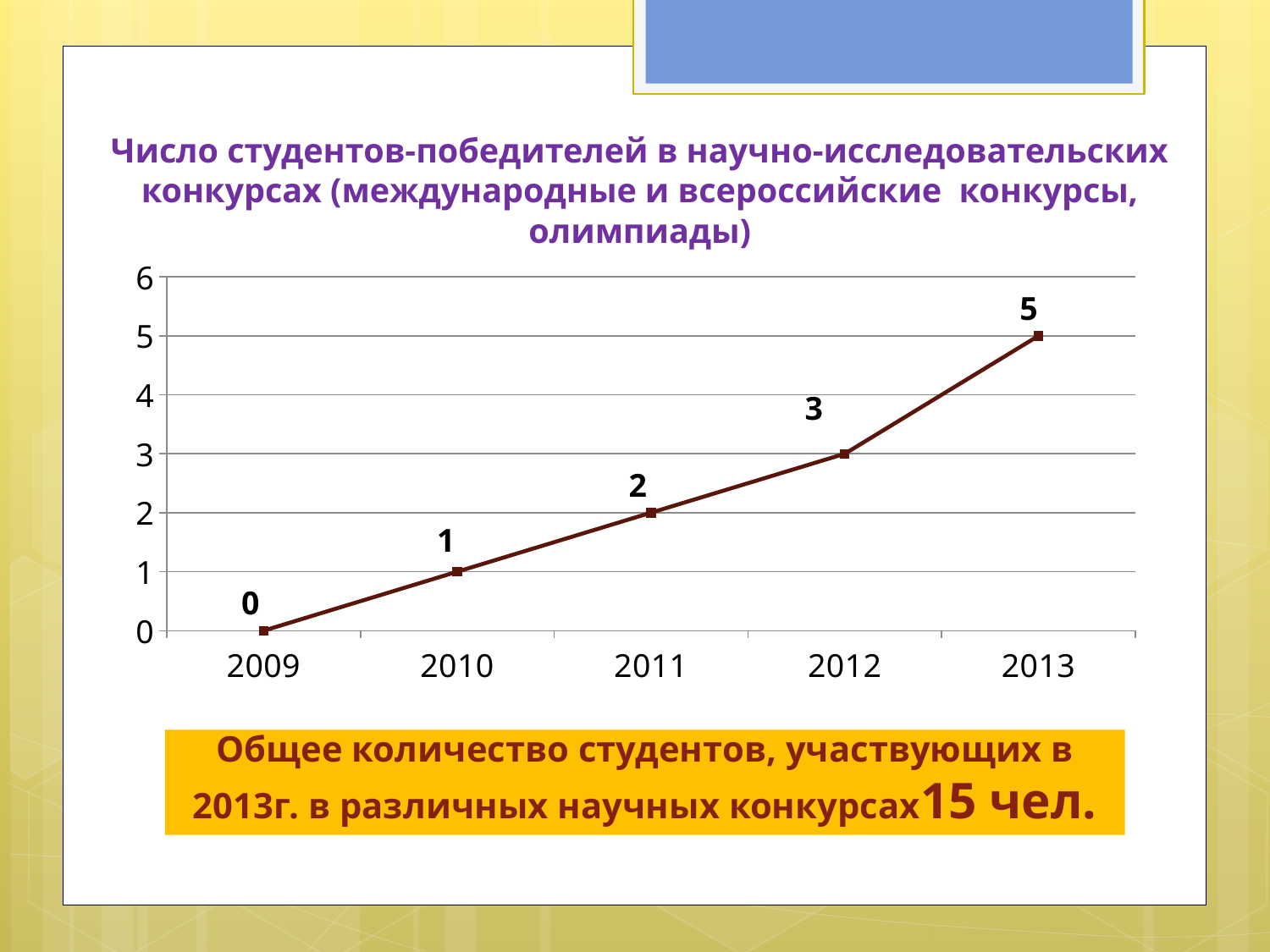
Do the values rise or fall from 2009 to 2013? rise What is the difference between the values for 2012 and 2010? 2 Which is larger, the value for 2010 or the value for 2012? 2012 What is the value for 2013? 5 What kind of chart is shown? line chart What is the value for 2011? 2 What is the difference between the values for 2013 and 2012? 2 Which year has the highest value? 2013 What is the value for 2009? 0 What is the highest tick value shown on the y axis? 6 How many years are plotted on the x axis? 5 Which year has the lowest value? 2009